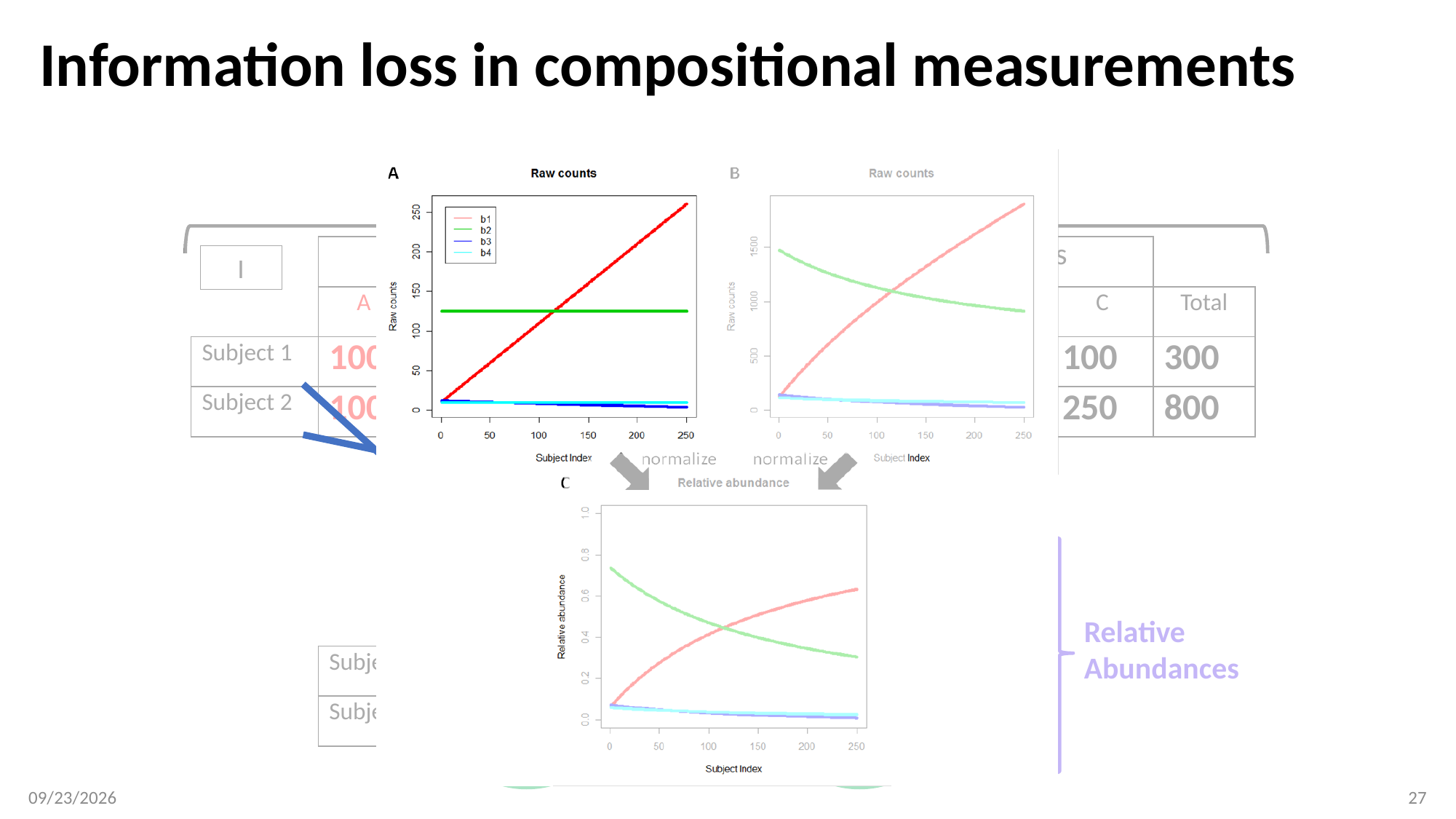
In chart A, is the value of b2 greater or less than 100? greater What kind of chart is chart A (Raw counts, top left)? line chart In chart B (Raw counts, top right), does the green line rise or fall as Subject Index increases? fall In chart A, does the b2 series rise, fall, or stay flat as Subject Index increases? stay flat In chart A, does the b1 series rise or fall as Subject Index increases? rise What is the title of chart C (bottom)? Relative abundance In chart A, is the value of b1 at Subject Index 250 greater or less than 200? greater What are the legend entries in chart A? b1, b2, b3, b4 In chart A, at Subject Index 250, which is larger, b1 or b2? b1 How many series does the legend in chart A list? 4 In chart B, is the value of the green line at Subject Index 0 greater or less than 1000? greater